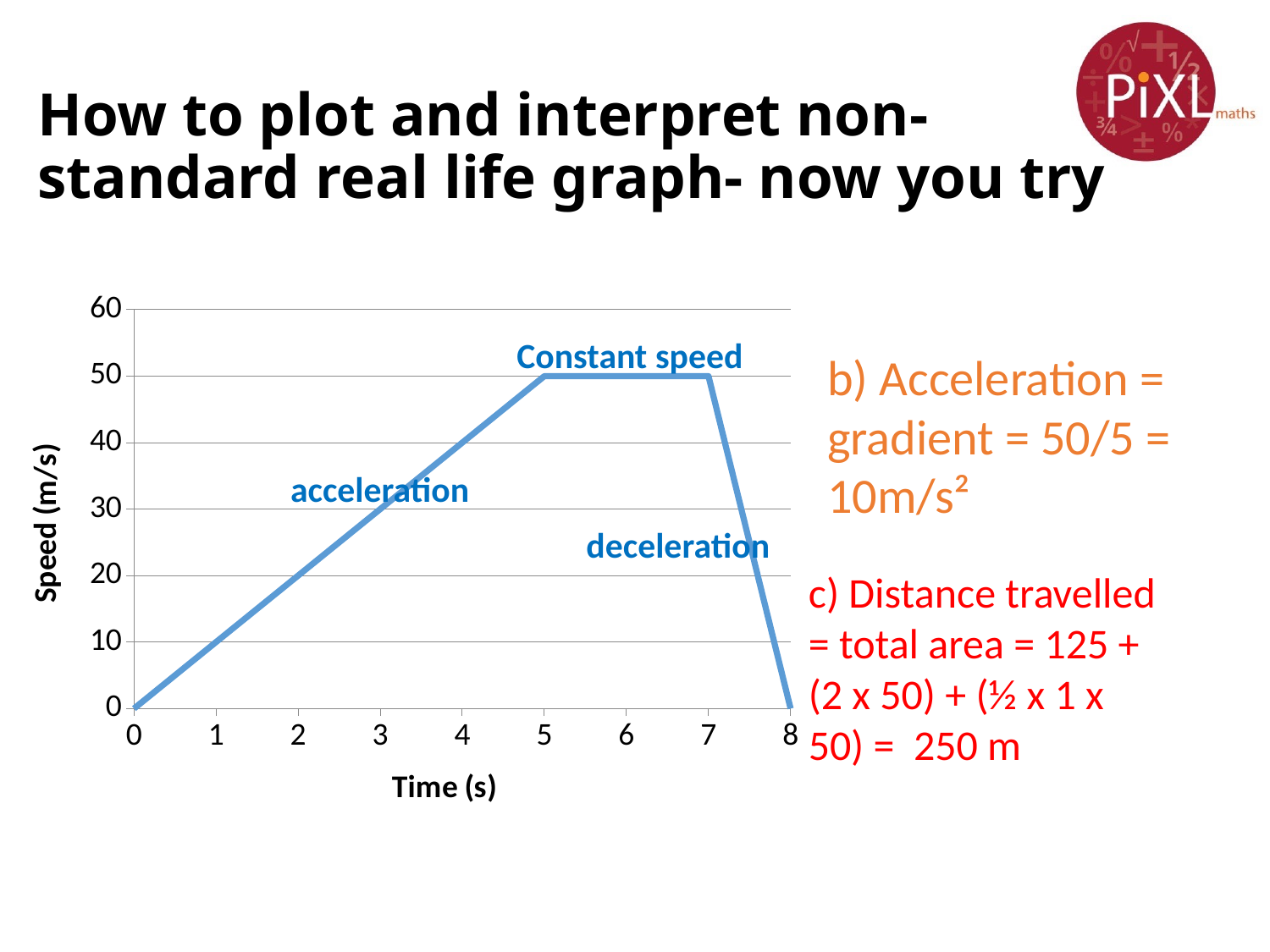
Does the speed rise, fall or stay constant between 7 s and 8 s? fall What is the highest speed reached on the graph? 50 Is the speed at time 2 s greater or less than 10? greater What is the speed at time 7 s? 50 What kind of chart is shown on the slide? line chart What label is written on the flat section of the graph between 5 s and 7 s? Constant speed Which is larger, the speed at 5 s or the speed at 8 s? 5 s Does the speed rise, fall or stay constant between 0 s and 5 s? rise What is the difference between the speed at 5 s and the speed at 0 s? 50 What is the speed at time 5 s? 50 Is the speed at time 3 s greater or less than 40? less What is the speed at time 8 s? 0